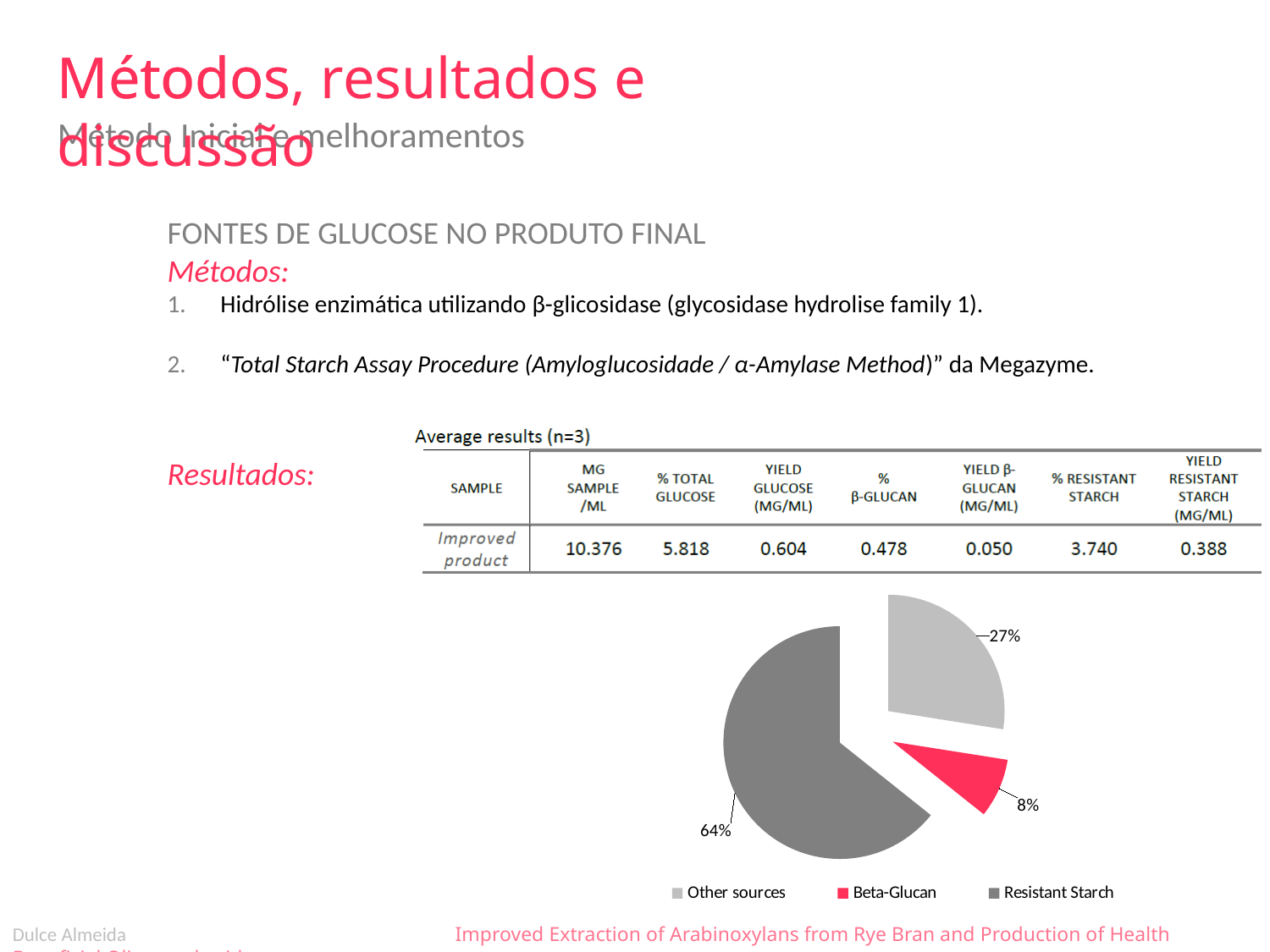
What is the difference in percentage points between the Resistant Starch slice and the Other sources slice? 37 Which is larger in the pie chart, Other sources or Beta-Glucan? Other sources Which category has the smallest slice of the pie? Beta-Glucan How many entries does the legend of the pie chart list? 3 What is the difference in percentage points between the Other sources slice and the Beta-Glucan slice? 19 How many slices does the pie chart have? 3 What kind of chart is shown on the slide? pie chart Which category has the largest slice of the pie? Resistant Starch Which legend entry of the pie chart is shown in pink/red? Beta-Glucan What share of the pie does Other sources represent? 27% What share of the pie does Beta-Glucan represent? 8% What share of the pie does Resistant Starch represent? 64%